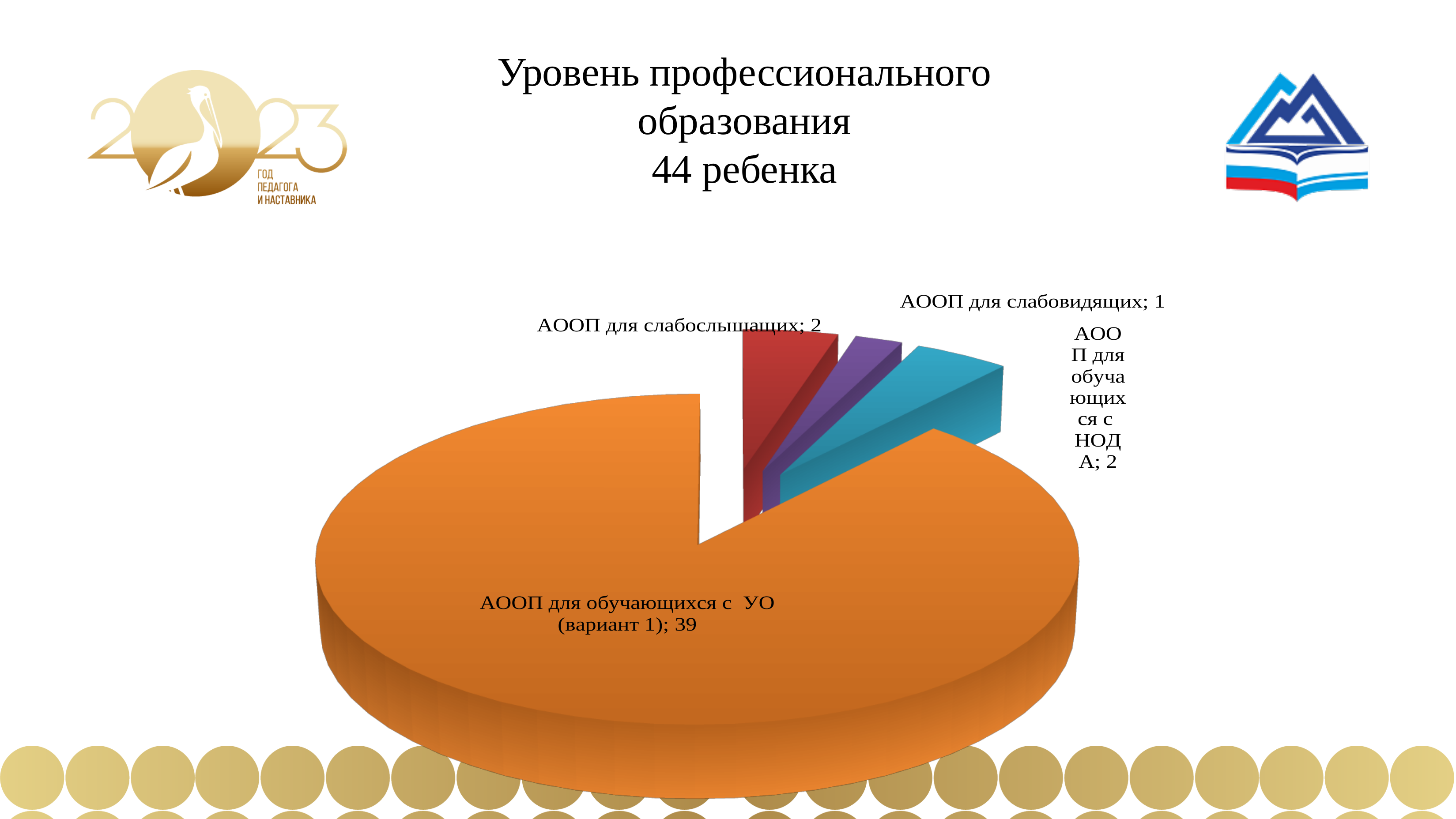
What is the value for АООП для обучающихся с НОДА? 2 What is the total of all the slice values in the pie chart? 44 Which category has the largest slice of the pie? АООП для обучающихся с УО (вариант 1) Which is larger, the value for АООП для слабослышащих or the value for АООП для слабовидящих? АООП для слабослышащих Which category has the smallest slice of the pie? АООП для слабовидящих What is the value for АООП для обучающихся с УО (вариант 1)? 39 What is the value for АООП для слабослышащих? 2 How many slices does the pie chart have? 4 What kind of chart is shown on the slide? Pie chart What is the difference between the values for АООП для обучающихся с УО (вариант 1) and АООП для слабослышащих? 37 What is the value for АООП для слабовидящих? 1 What is the title of the chart on the slide? Уровень профессионального образования 44 ребенка